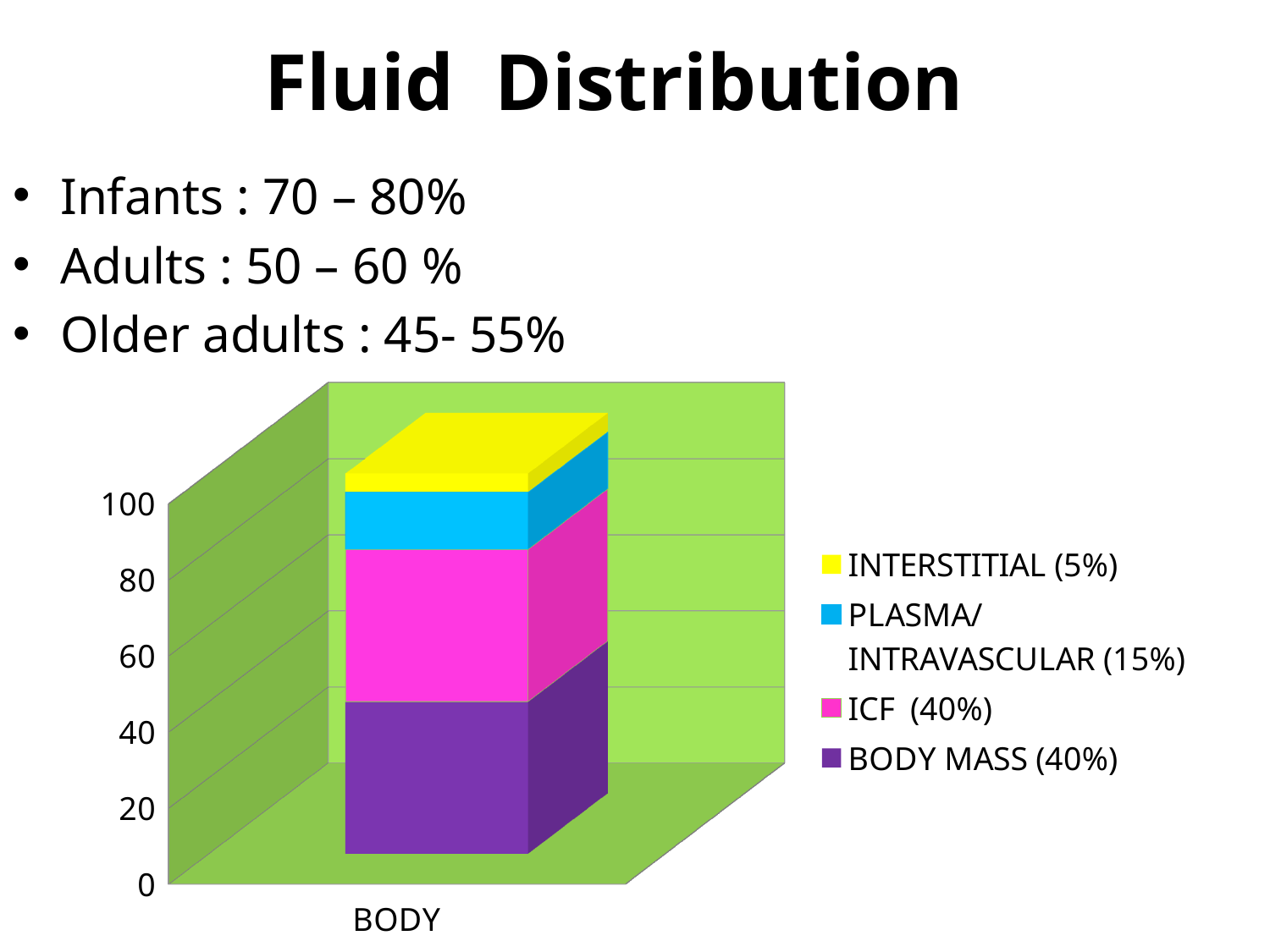
Which is larger, the ICF value or the PLASMA/INTRAVASCULAR value? ICF According to the legend, what percentage is given for BODY MASS? 40% What is the difference between the ICF value and the PLASMA/INTRAVASCULAR value? 25% According to the legend, what percentage is given for ICF? 40% Which series has the smallest value in the chart? INTERSTITIAL (5%) What is the category label on the x axis of the chart? BODY What kind of chart is shown on the slide? bar chart According to the legend, what percentage is given for PLASMA/INTRAVASCULAR? 15% According to the legend, what percentage is given for INTERSTITIAL? 5% How many categories are shown on the x axis of the chart? 1 What is the total of the stacked bar for BODY? 100% How many series does the chart legend list? 4